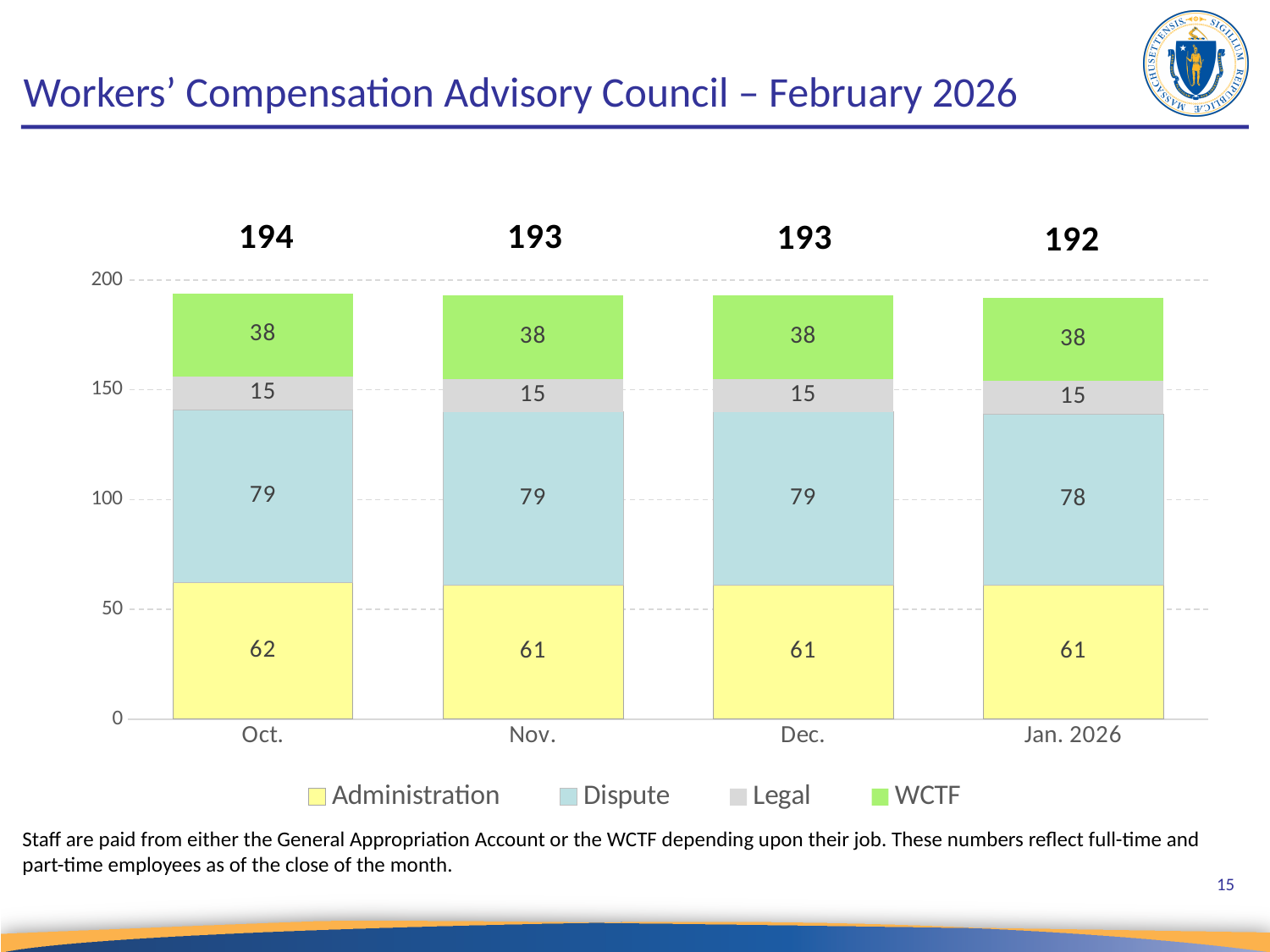
How many series does the legend list? 4 Which month has the lowest total? Jan. 2026 What is the Legal value for Nov.? 15 What is the total of the stacked bar for Jan. 2026? 192 What is the WCTF value for Dec.? 38 What is the Dispute value for Jan. 2026? 78 What is the difference between the Dispute value for Oct. and the Dispute value for Jan. 2026? 1 What is the Administration value for Oct.? 62 What kind of chart is shown on the slide? Stacked bar chart Which month has the highest total? Oct. What is the total of the stacked bar for Oct.? 194 How many months are shown on the x axis? 4